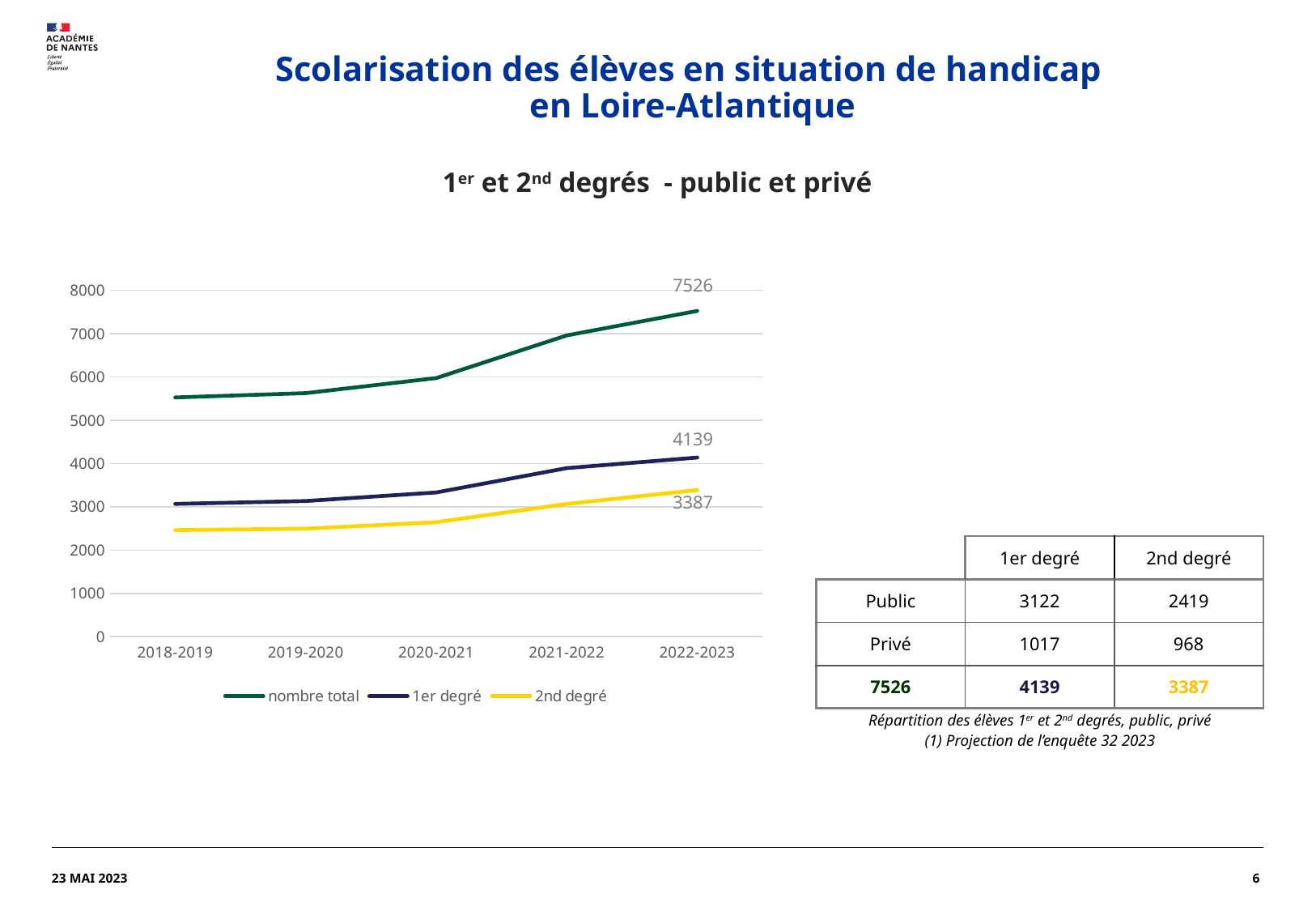
What is the difference between the 'nombre total' and '1er degré' values in 2022-2023? 3387 What kind of chart is shown on the slide? Line chart How many school years are plotted on the x axis of the chart? 5 What is the difference between the '1er degré' and '2nd degré' values in 2022-2023? 752 What is the value of the 'nombre total' series for 2022-2023? 7526 What is the value of the '1er degré' series for 2022-2023? 4139 Does the 'nombre total' series rise or fall from 2018-2019 to 2022-2023? Rise What is the value of the '2nd degré' series for 2022-2023? 3387 In which school year does the 'nombre total' series reach its highest value? 2022-2023 Is the value of 'nombre total' for 2018-2019 greater or less than 6000? less Is the value of '2nd degré' for 2018-2019 greater or less than 3000? less How many series does the chart legend list? 3